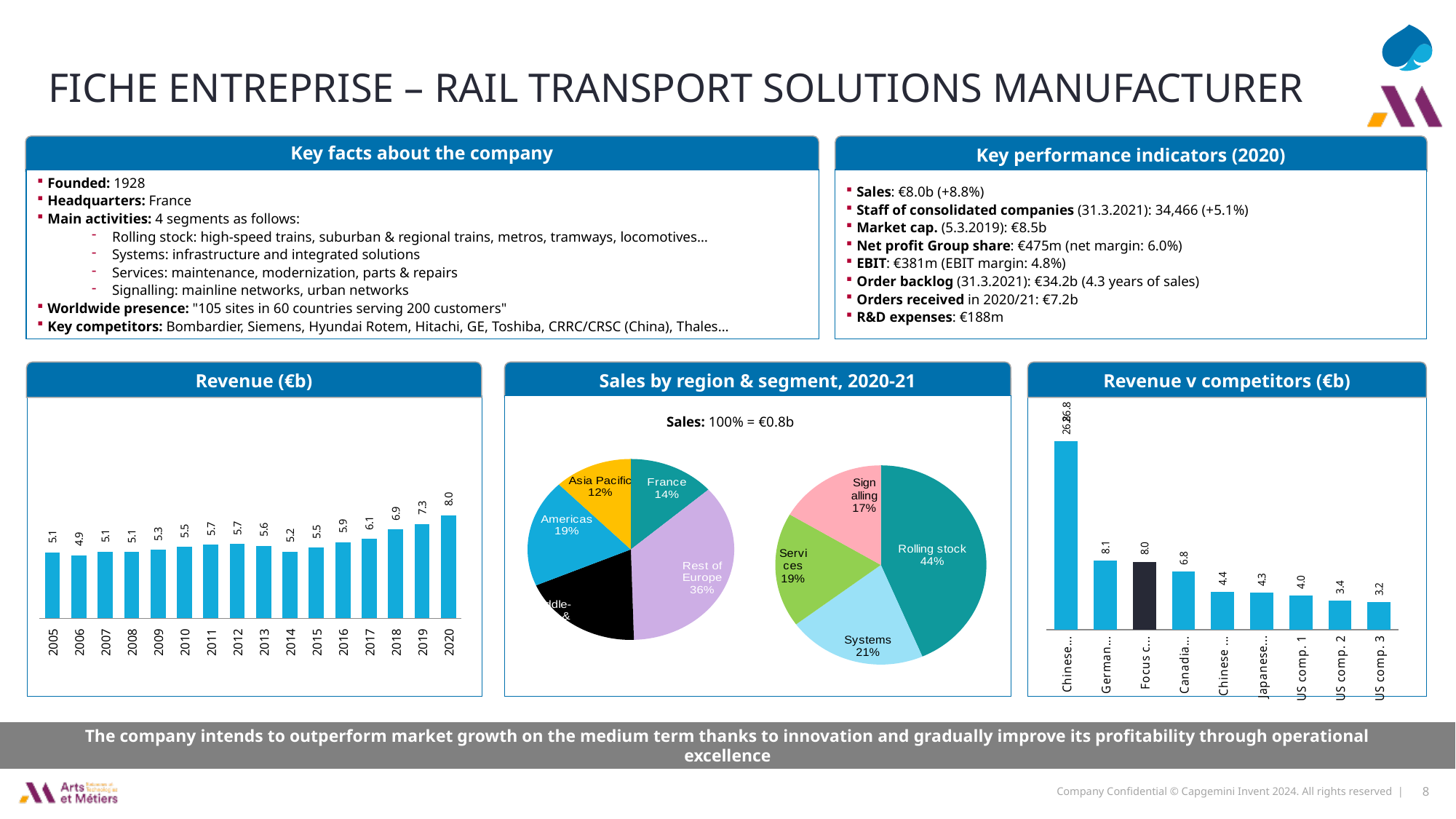
In the Revenue (€b) chart, do values generally rise or fall from 2015 to 2020? rise In the Revenue (€b) chart, which year has the lowest revenue? 2006 In the Revenue (€b) chart, what is the difference between the 2020 and 2019 revenue? 0.7 In the Sales by region & segment chart, what share of sales does Rolling stock account for? 44% In the Revenue v competitors (€b) chart, what is the value for US comp. 3? 3.2 In the Revenue (€b) chart, how many years are plotted? 16 In the Revenue (€b) chart, what is the revenue for 2020? 8.0 In the Revenue (€b) chart, what is the revenue for 2014? 5.2 In the Revenue v competitors (€b) chart, how many companies are plotted? 9 In the Sales by region & segment chart, what share of sales does Rest of Europe account for? 36% In the Sales by region & segment chart, which is larger, the Systems share or the Services share? Systems In the Revenue (€b) chart, which year has the highest revenue? 2020